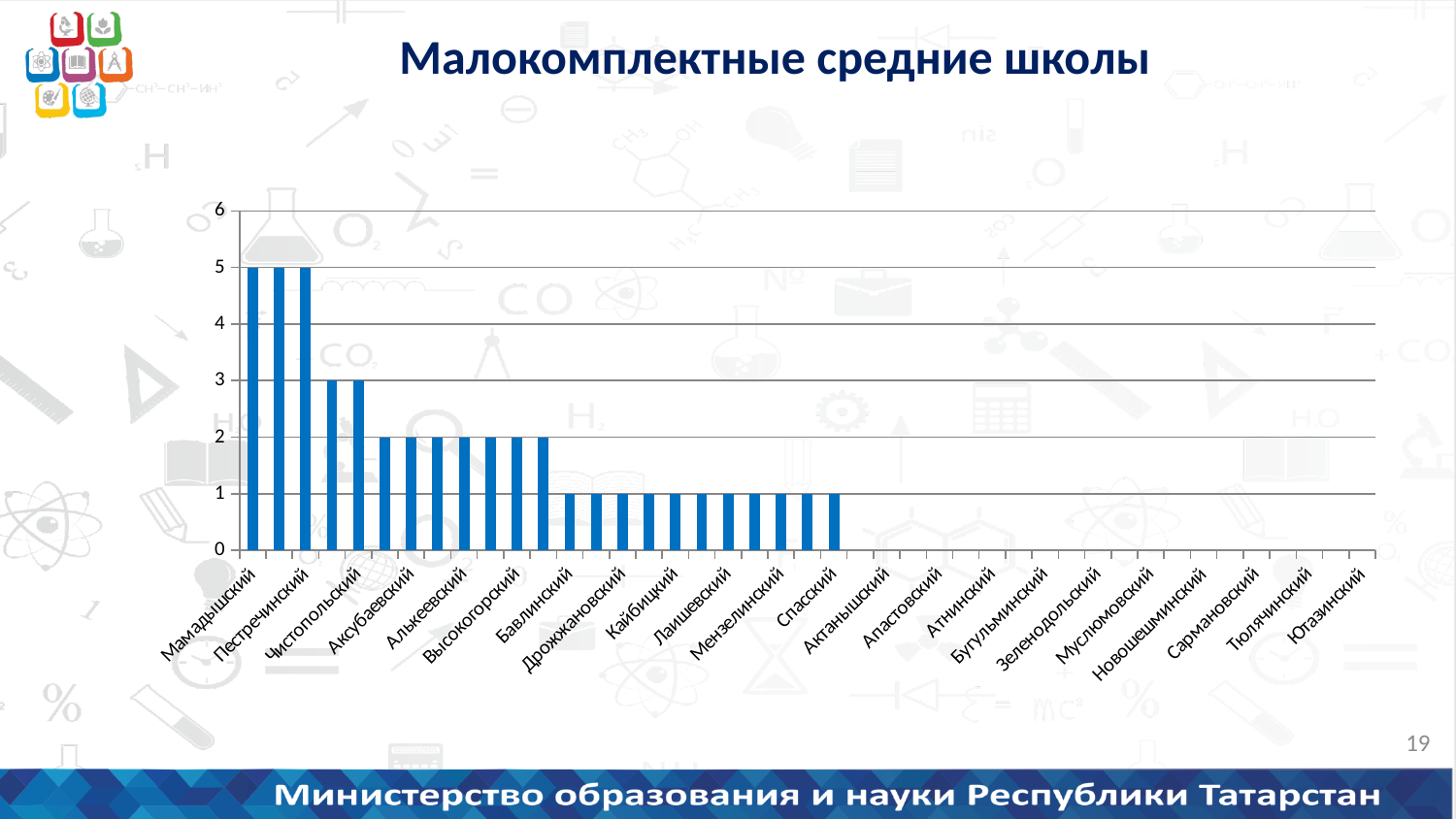
Do the bar values generally rise or fall from left to right along the x axis? fall Which has the larger value, Мамадышский or Ютазинский? Мамадышский What is the highest value reached by any bar in the chart? 5 How many categories (districts) are labelled on the x axis of the chart? 22 What is the value for Мамадышский? 5 What is the title of the chart? Малокомплектные средние школы What kind of chart is shown on the slide? bar chart Is the value for Ютазинский greater or less than 1? less What is the lowest value shown on the chart's vertical axis? 0 Is the value for Мамадышский greater or less than 4? greater